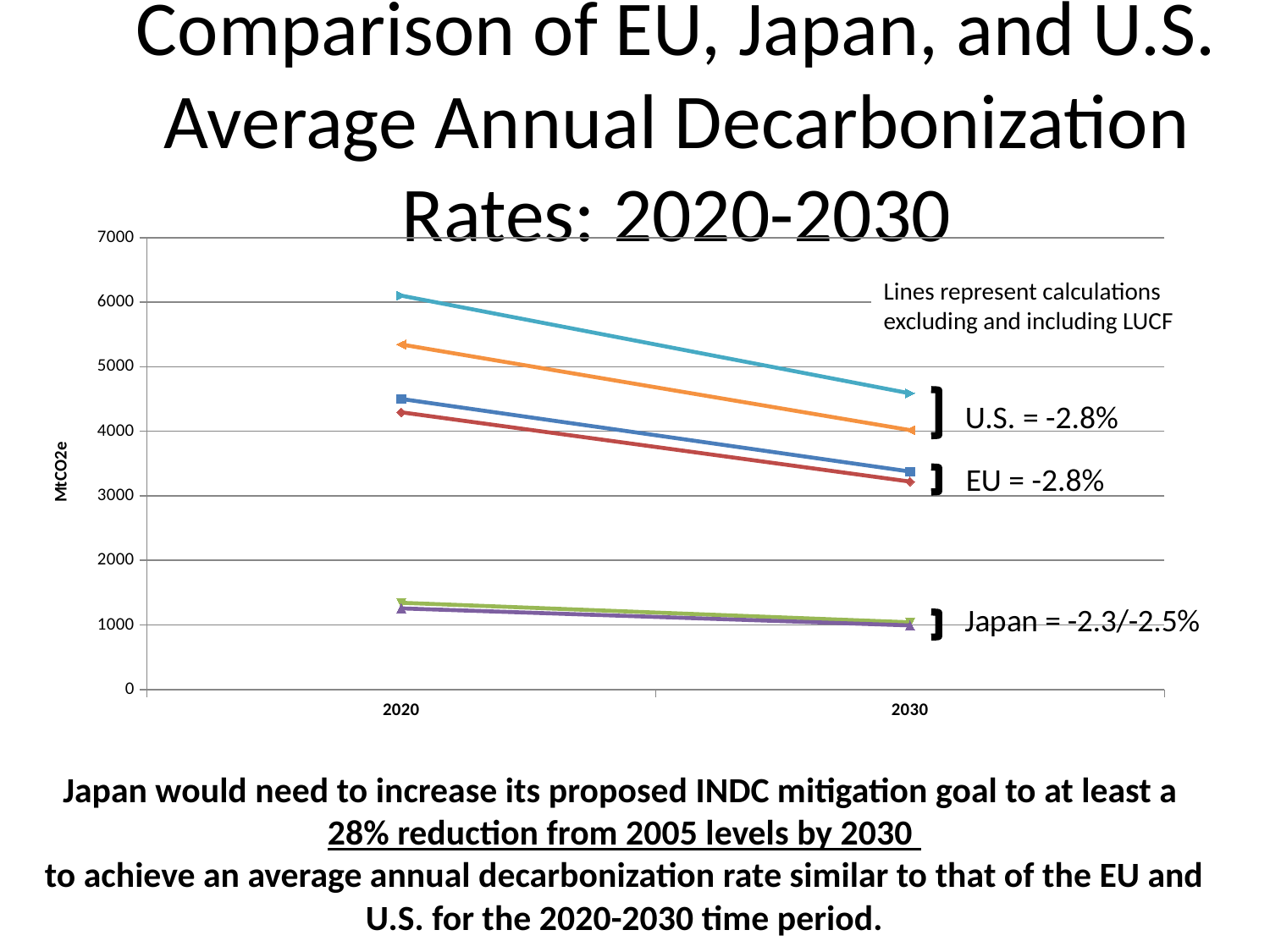
What average annual decarbonization rate is labelled for Japan on the chart? -2.3/-2.5% Are the values of the Japan lines in 2030 greater or less than 2000? less Is the value of the highest U.S. line in 2020 greater or less than 5000? greater How many years are marked on the x axis of the chart? 2 What kind of chart is shown on the slide? line chart Which country's lines are the lowest on the chart? Japan Do the plotted lines rise or fall from 2020 to 2030? fall Which country's lines are the highest on the chart? U.S. What average annual decarbonization rate is labelled for the U.S. on the chart? -2.8% What average annual decarbonization rate is labelled for the EU on the chart? -2.8% How many lines are plotted on the chart? 6 What is the label on the y axis of the chart? MtCO2e